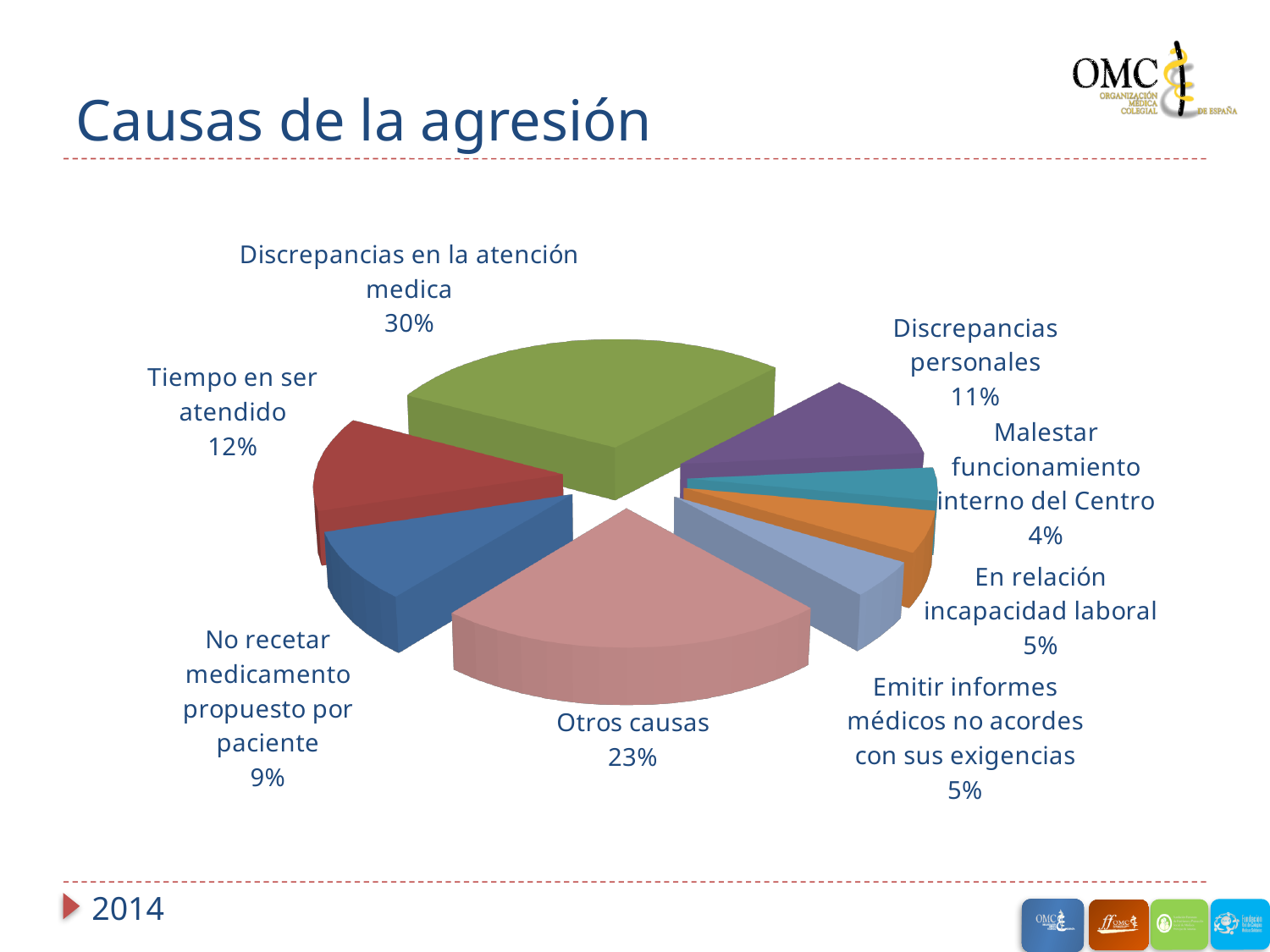
Which is larger: 'Discrepancias personales' or 'Tiempo en ser atendido'? Tiempo en ser atendido What is the title of the slide containing the pie chart? Causas de la agresión What share of the pie is 'No recetar medicamento propuesto por paciente'? 9% What share of the pie is 'Discrepancias en la atención medica'? 30% How many slices does the pie chart have? 8 What share of the pie is 'Tiempo en ser atendido'? 12% What is the difference in percentage points between 'Discrepancias en la atención medica' and 'Otros causas'? 7 Which cause has the smallest share of the pie? Malestar funcionamiento interno del Centro Which cause has the largest share of the pie? Discrepancias en la atención medica What kind of chart is shown on the slide? Pie chart